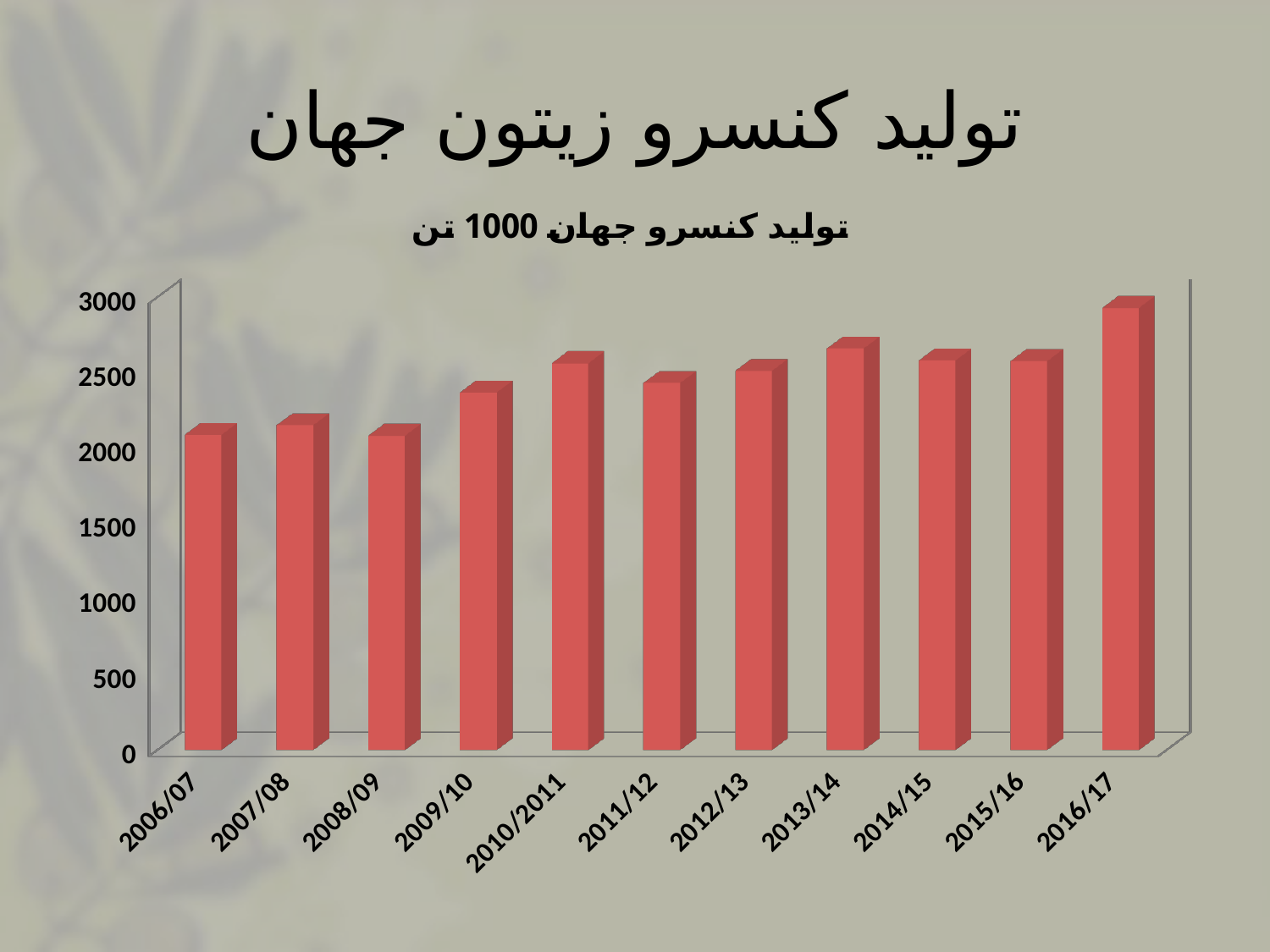
What is the title printed directly above the chart? تولید کنسرو جهان 1000 تن Is the value for 2007/08 greater or less than 2000? greater What kind of chart is shown on the slide? bar chart How many categories (seasons) are plotted on the x axis? 11 Is the value for 2009/10 greater or less than 2500? less Which season has the highest value? 2016/17 Is the value for 2006/07 greater or less than 2500? less Which is larger, the value for 2016/17 or the value for 2006/07? 2016/17 Which is larger, the value for 2013/14 or the value for 2011/12? 2013/14 Overall, do the values rise or fall from 2006/07 to 2016/17? rise